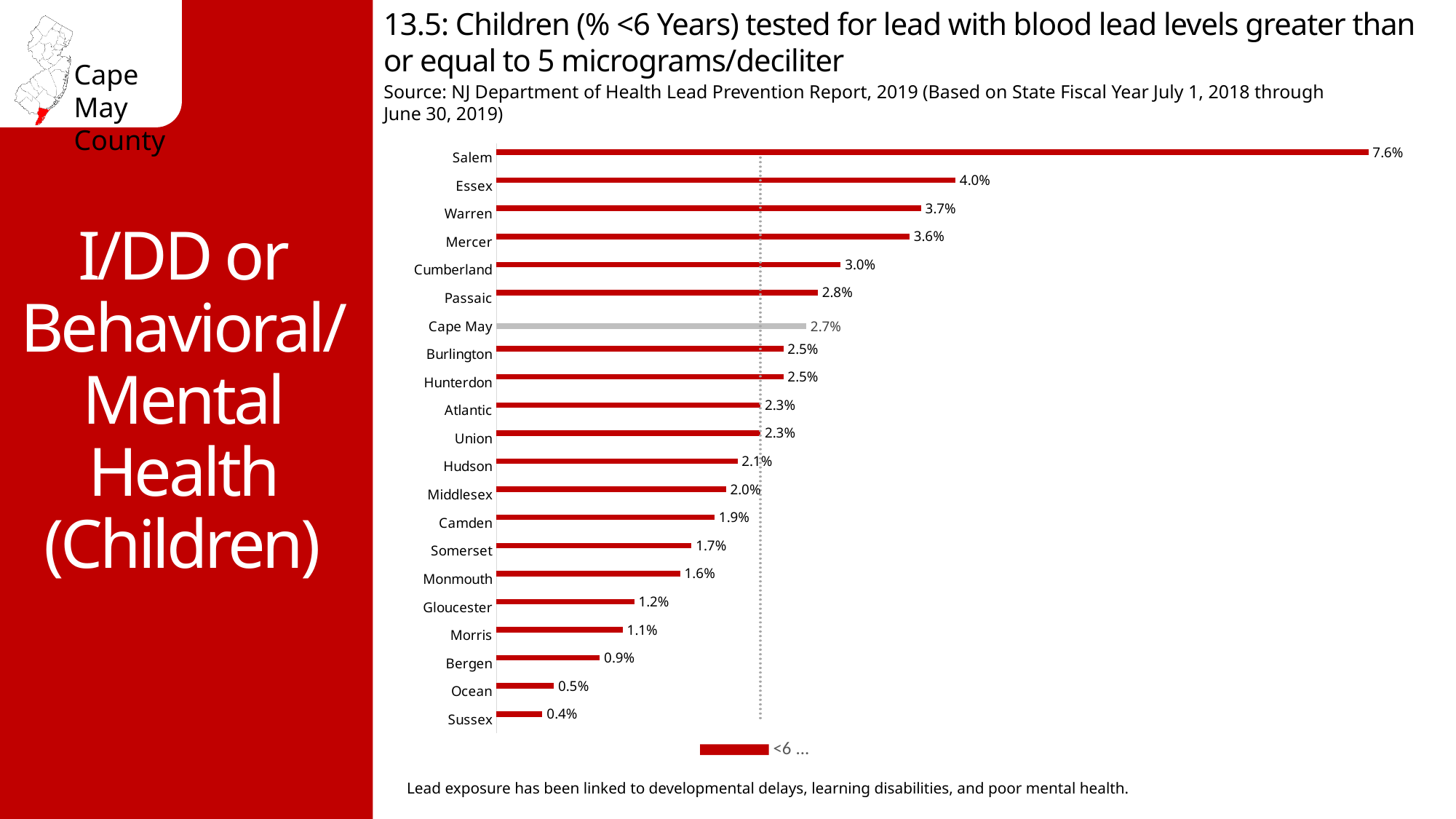
Which county has the lowest value? Sussex Which is larger, the value for Mercer or the value for Cumberland? Mercer What kind of chart is shown on the slide? Bar chart Which is larger, the value for Bergen or the value for Gloucester? Gloucester What is the value for Salem? 7.6% Which county has the highest value? Salem What is the value for Sussex? 0.4% How many counties are shown in the chart? 21 What is the value for Cape May? 2.7% What is the difference between the values for Cape May and Sussex? 2.3% What is the difference between the values for Salem and Essex? 3.6% Which county's bar is shown in gray rather than red? Cape May